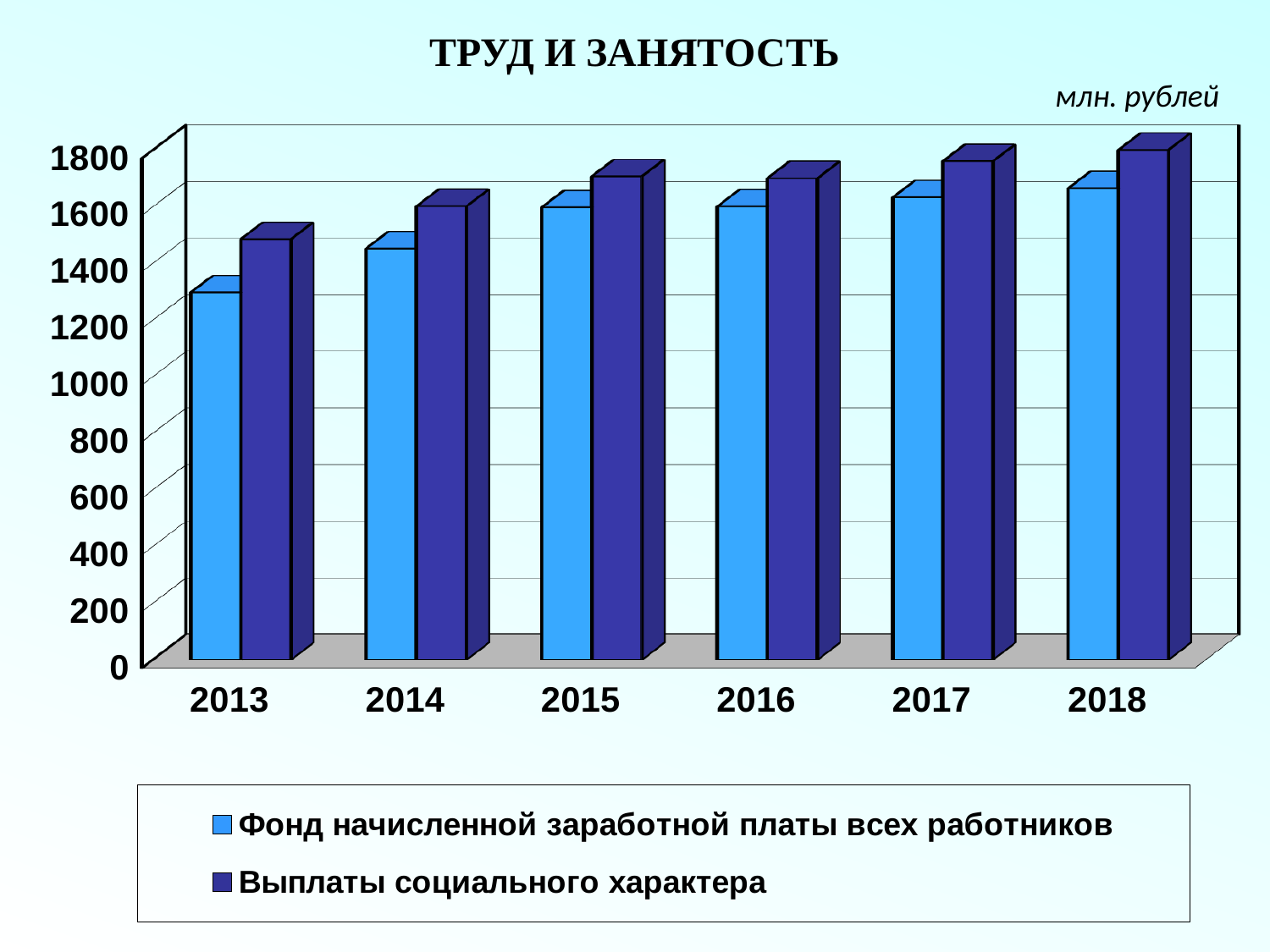
How many series does the legend list? 2 What is the title of the chart? ТРУД И ЗАНЯТОСТЬ Is the value for Выплаты социального характера in 2018 greater or less than 1600? greater In what units are the values on the chart given? млн. рублей What kind of chart is shown on the slide? bar chart Is the value for Фонд начисленной заработной платы всех работников in 2013 greater or less than 1400? less How many years are shown on the x axis of the chart? 6 Is the value for Фонд начисленной заработной платы всех работников in 2014 greater or less than 1600? less In which year is Фонд начисленной заработной платы всех работников lowest? 2013 In which year is Выплаты социального характера highest? 2018 In 2013, which is larger: Фонд начисленной заработной платы всех работников or Выплаты социального характера? Выплаты социального характера